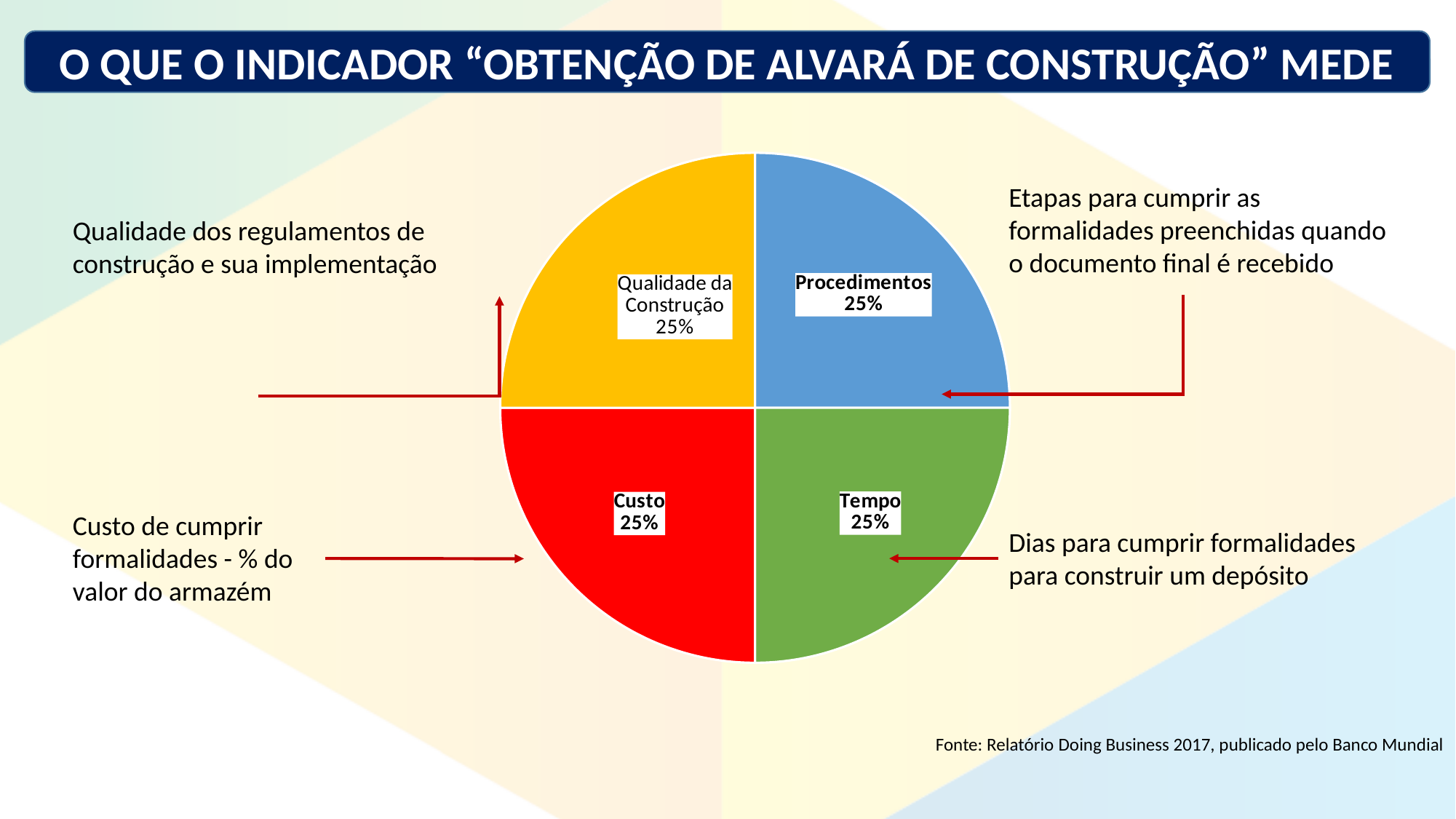
What is the combined share of the Procedimentos and Tempo slices? 50% What kind of chart is shown on the slide? pie chart What is the value shown for the Qualidade da Construção slice? 25% Which slice of the pie chart is coloured red? Custo What is the value shown for the Tempo slice? 25% Which slice of the pie chart is coloured green? Tempo How many slices does the pie chart have? 4 What is the difference between the Custo slice and the Tempo slice? 0% What share of the pie does the Procedimentos slice represent? 25% What is the value shown for the Custo slice? 25% Do all four slices of the pie chart have the same value? yes Is the value for Procedimentos greater or less than 20%? greater